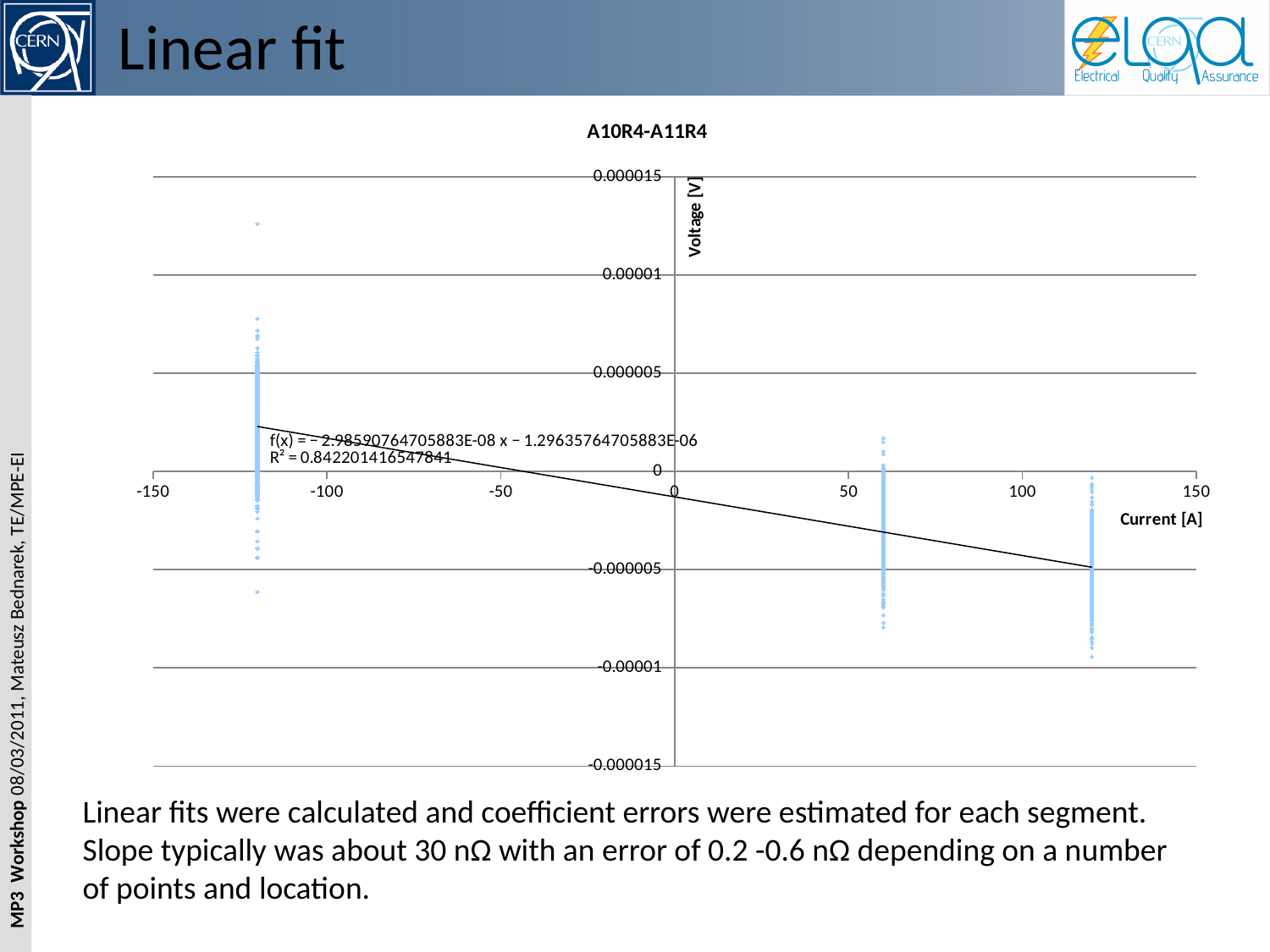
Is the fitted line's value at a current of 120 A greater or less than 0? less What is the R² value of the linear fit shown on the chart? 0.842201416547841 Does the fitted line rise or fall as current increases along the x axis? fall How many distinct current values (clusters of points) are plotted on the chart? 3 What is the title of the chart? A10R4-A11R4 What kind of chart is shown on the slide? scatter chart What is the fitted equation f(x) printed on the chart? f(x) = − 2.98590764705883E-08 x − 1.29635764705883E-06 What is the label of the x axis of the chart? Current [A] What is the maximum value shown on the y axis of the chart? 0.000015 Is the fitted line's value at a current of -120 A greater or less than 0? greater What is the minimum value shown on the x axis of the chart? -150 How many tick labels are shown on the x axis of the chart? 7